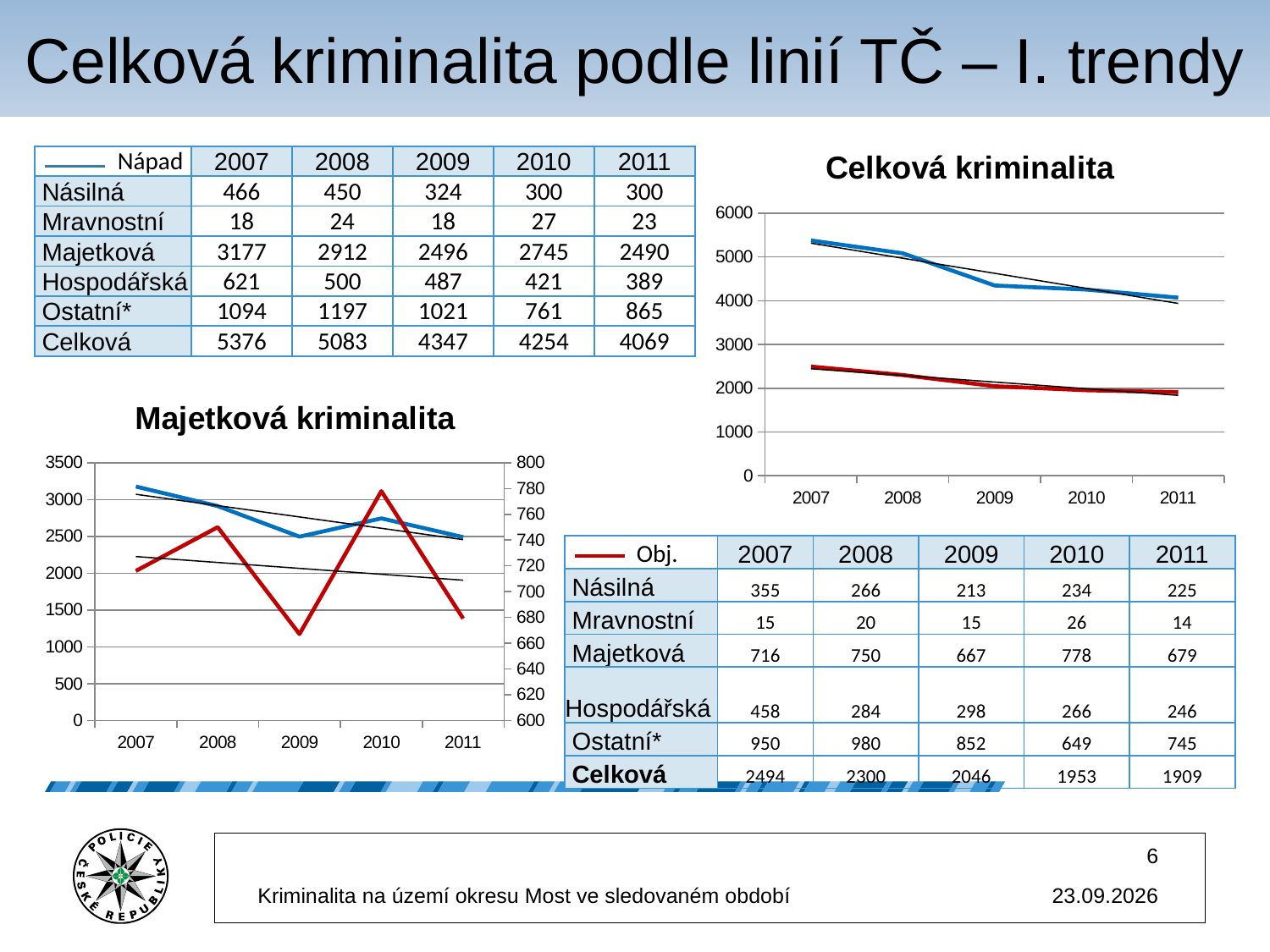
In the 'Majetková kriminalita' chart, is the blue line's value for 2007 greater or less than 3000? greater How many years are shown on the x axis of the 'Celková kriminalita' chart? 5 In the 'Majetková kriminalita' chart, in which year does the red line reach its lowest point? 2009 In the 'Celková kriminalita' chart, does the blue line rise or fall from 2007 to 2011? fall What kind of chart is the 'Majetková kriminalita' chart? line chart In the 'Celková kriminalita' chart, is the blue line's value for 2011 greater or less than 5000? less In the 'Celková kriminalita' chart, is the red line's value for 2007 greater or less than 2000? greater In the 'Celková kriminalita' chart, which line is higher in 2009, the blue line or the red line? blue line In the 'Majetková kriminalita' chart, in which year does the red line reach its highest point? 2010 In the 'Majetková kriminalita' chart, in which year is the blue line at its highest? 2007 What kind of chart is the 'Celková kriminalita' chart? line chart